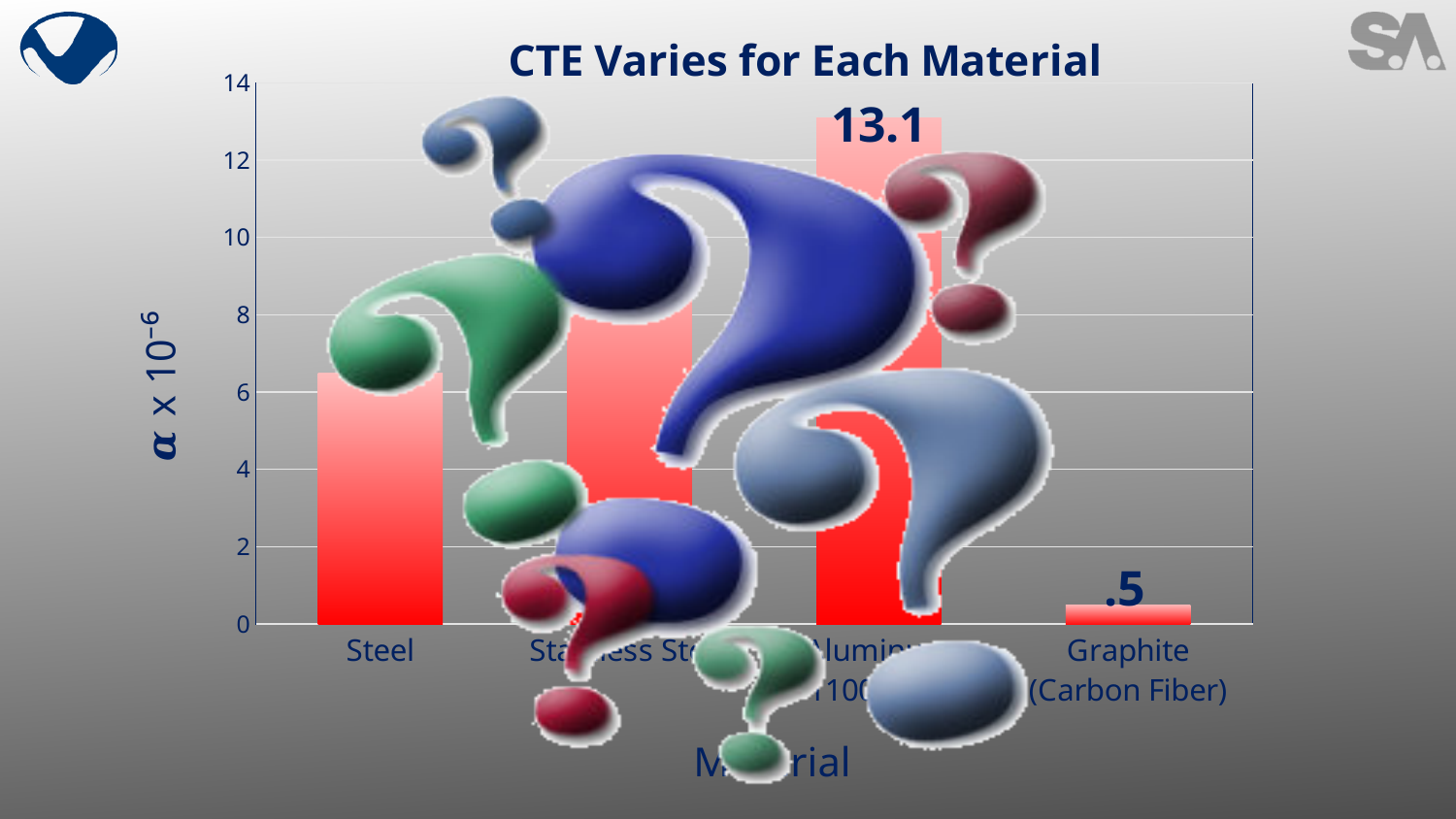
Is the value for Steel greater or less than 8? less Which material has the lowest value in the chart? Graphite (Carbon Fiber) Which has the larger value, Steel or Graphite (Carbon Fiber)? Steel Is the value for Steel greater or less than 4? greater Which has the larger value, Steel or Stainless Steel? Stainless Steel How many materials (bars) are plotted in the chart? 4 What is the title of the chart? CTE Varies for Each Material What value is printed above the tallest bar (the third bar from the left)? 13.1 Is the value for Stainless Steel greater or less than 6? greater What is the difference between the bar labeled 13.1 and the Graphite (Carbon Fiber) bar? 12.6 What is the value shown for Graphite (Carbon Fiber)? .5 What kind of chart is shown on the slide? bar chart